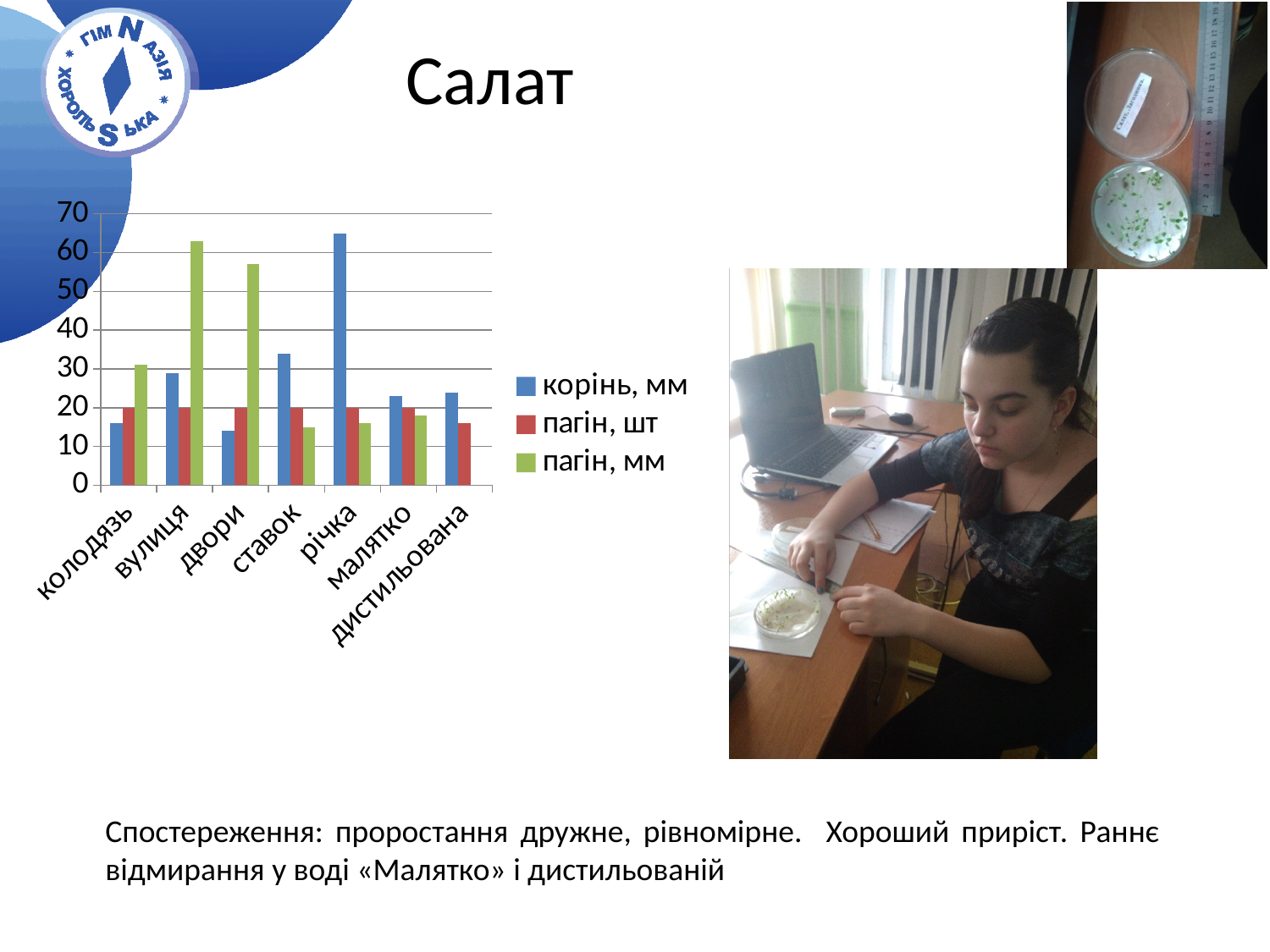
What are the three series listed in the chart legend? корінь, мм; пагін, шт; пагін, мм How many series does the chart legend list? 3 Is the value of 'пагін, мм' for ставок greater or less than 20? less Is the value of 'корінь, мм' for річка greater or less than 60? greater Which category has the highest value for the series 'пагін, мм'? вулиця Is the value of 'корінь, мм' for колодязь greater or less than 20? less How many categories are shown on the x axis of the chart? 7 Which is larger: the value of 'пагін, мм' for двори or for ставок? двори Which is larger: the value of 'корінь, мм' for ставок or for вулиця? ставок What kind of chart is shown on the slide? bar chart Which category has the highest value for the series 'корінь, мм'? річка